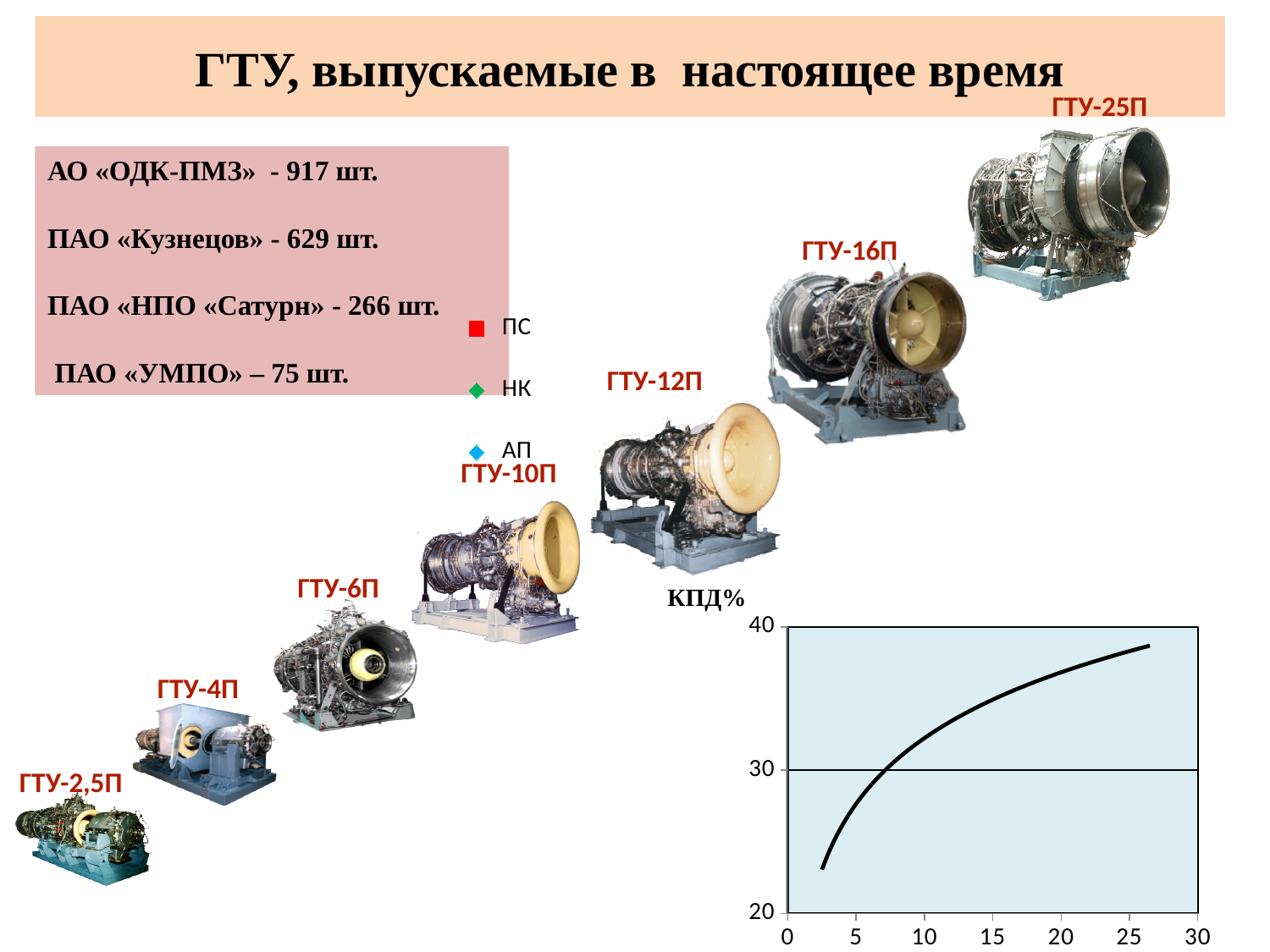
Is the value at the left end of the curve greater or less than 30? less How many curves are plotted on the chart? 1 What is the highest tick value shown on the horizontal axis of the chart? 30 What is the label on the vertical axis of the chart? КПД% Is the value of the curve at x = 20 greater or less than 30? greater What is the highest tick value shown on the vertical axis of the chart? 40 Is the value of the curve at x = 10 greater or less than 30? greater Does the curve on the chart rise or fall as the x-axis value increases? rises What kind of chart is shown at the bottom right of the slide? line chart